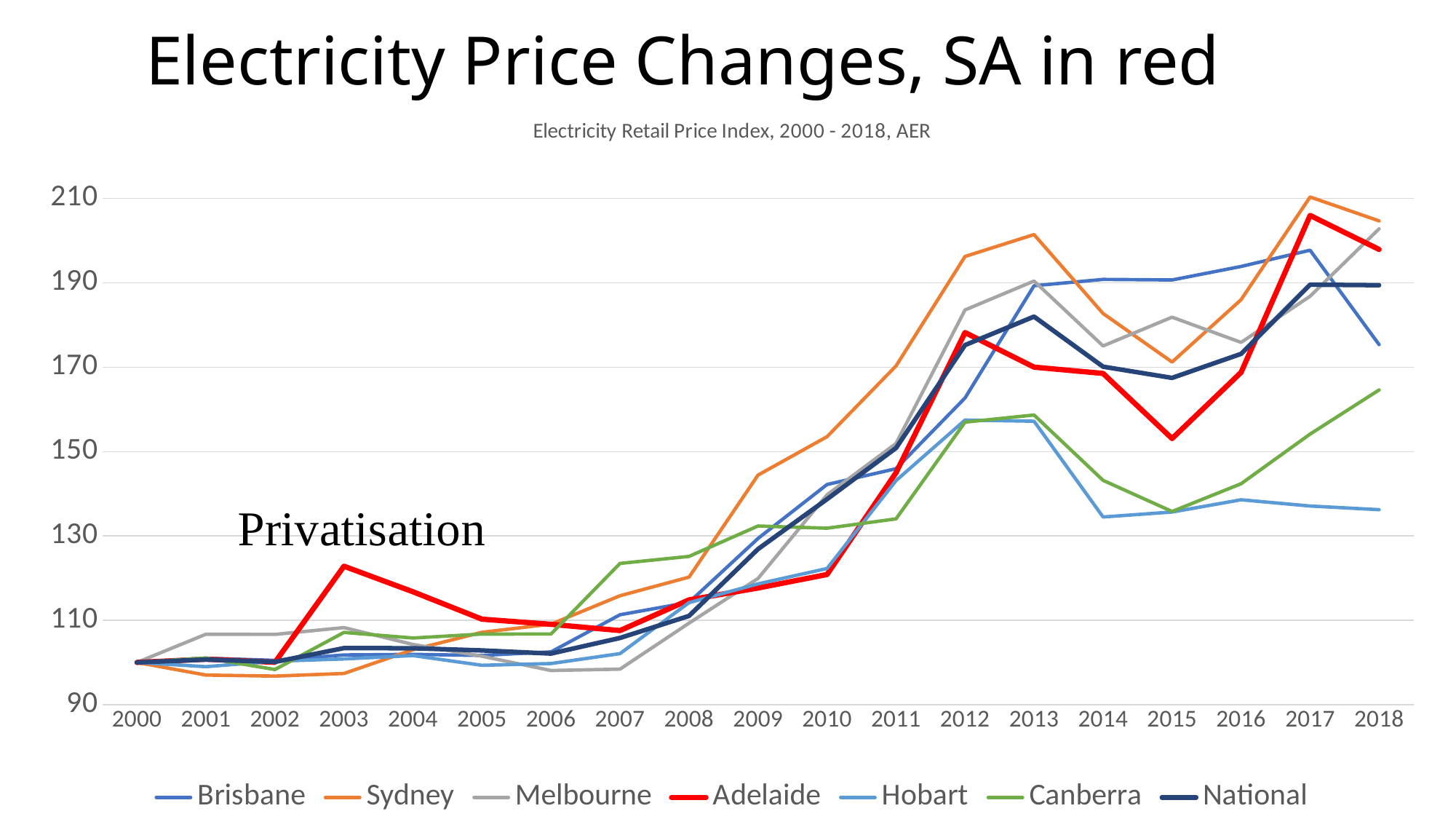
How many series does the legend list? 7 Is the value for Hobart in 2018 greater or less than 150? less Which series is highest in 2003? Adelaide Does the Adelaide line rise or fall from 2012 to 2015? Fall Is the value for Canberra in 2018 greater or less than 150? greater Which series is highest in 2017? Sydney In 2018, which is larger, Adelaide or Canberra? Adelaide What is the subtitle printed below the main title? Electricity Retail Price Index, 2000 - 2018, AER Which series is lowest in 2018? Hobart What kind of chart is shown on the slide? Line chart How many years are shown along the x axis? 19 Is the value for Adelaide in 2015 greater or less than 170? less